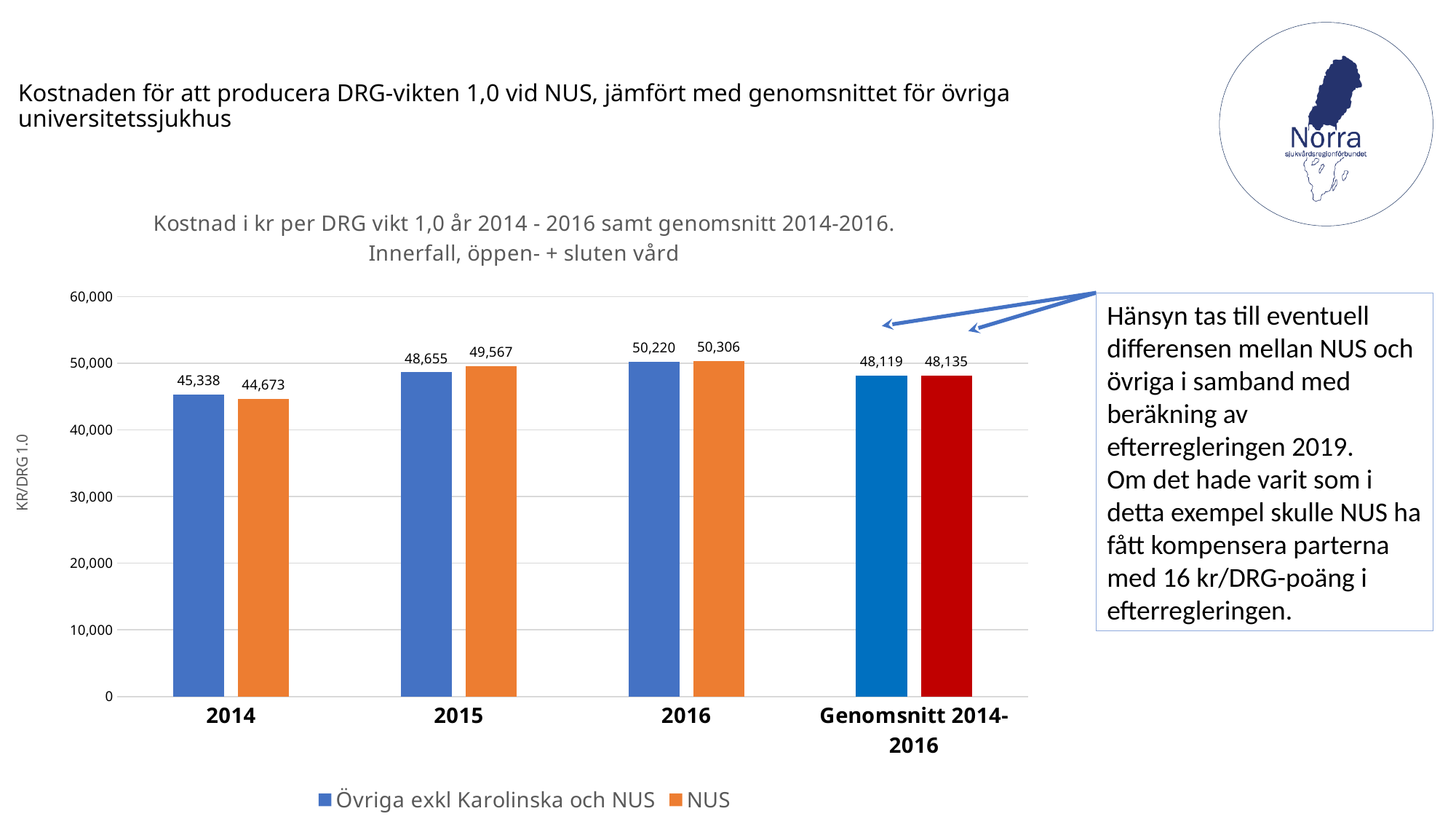
What kind of chart is shown on the slide? Bar chart How many series does the legend list? 2 What is the difference between the two series for Genomsnitt 2014-2016? 16 In 2014, which series has the larger value: NUS or Övriga exkl Karolinska och NUS? Övriga exkl Karolinska och NUS What is the difference between the NUS value and the Övriga exkl Karolinska och NUS value in 2015? 912 What is the NUS value for Genomsnitt 2014-2016? 48,135 What is the value for Övriga exkl Karolinska och NUS in 2016? 50,220 How many categories are shown on the x axis? 4 What is the value for NUS in 2014? 44,673 Does the NUS series rise or fall from 2014 to 2016? Rise In which category does the NUS series reach its highest value? 2016 In which category is the Övriga exkl Karolinska och NUS series lowest? 2014